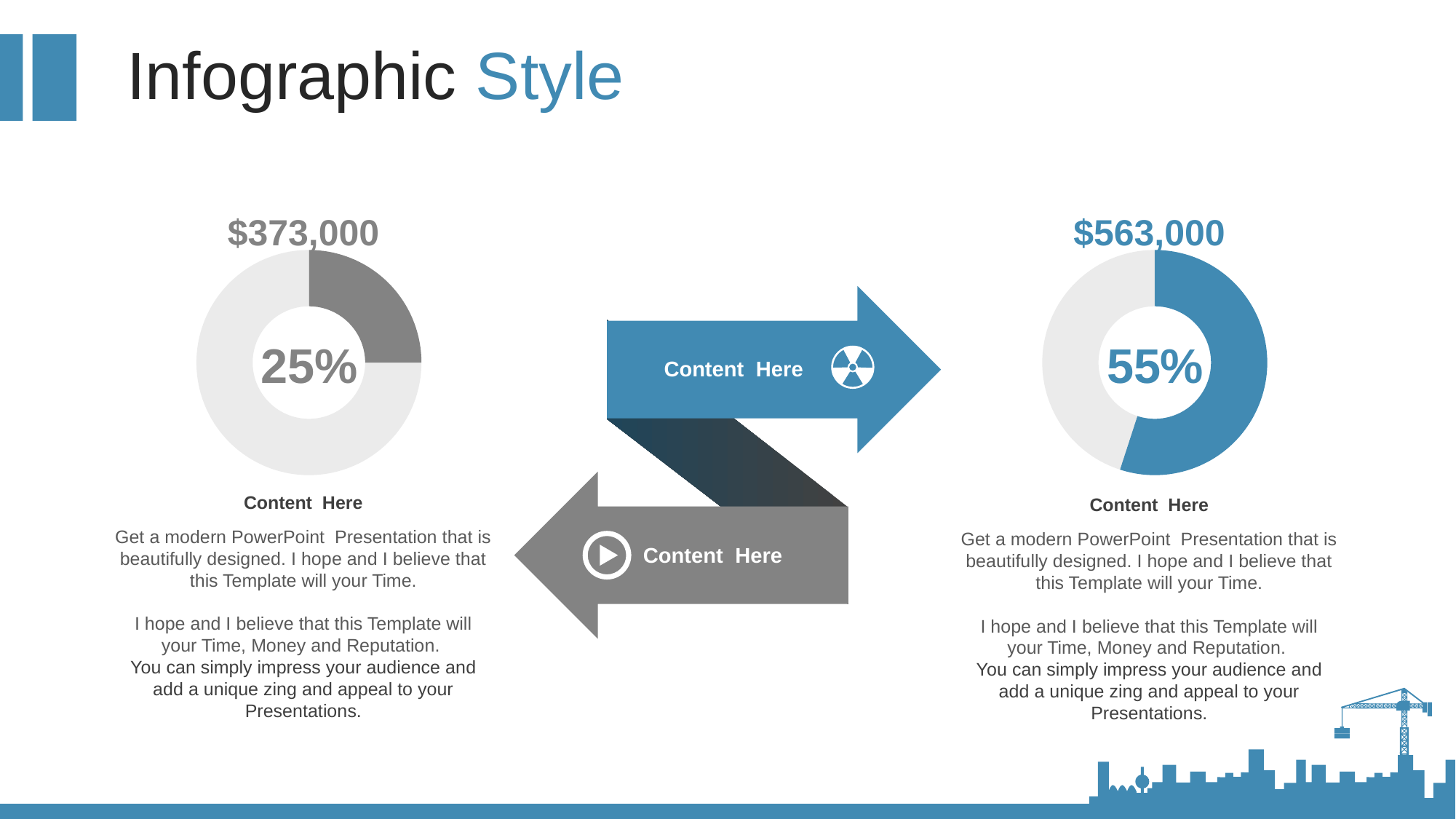
What colour is the filled segment of the right donut chart? Blue What kind of chart is used on the left side of the slide? Donut chart How many donut charts are on the slide? 2 What percentage is shown in the centre of the right donut chart? 55% Which donut chart shows the larger percentage, the left one or the right one? The right one (55%) What share of the right donut chart is filled by the blue segment? 55% What dollar value is printed above the right donut chart? $563,000 What dollar value is printed above the left donut chart? $373,000 What is the difference between the dollar value above the right donut chart and the dollar value above the left donut chart? $190,000 What share of the left donut chart is filled by the dark grey segment? 25% What percentage is shown in the centre of the left donut chart? 25% What is the difference in percentage points between the right donut chart (55%) and the left donut chart (25%)? 30 percentage points